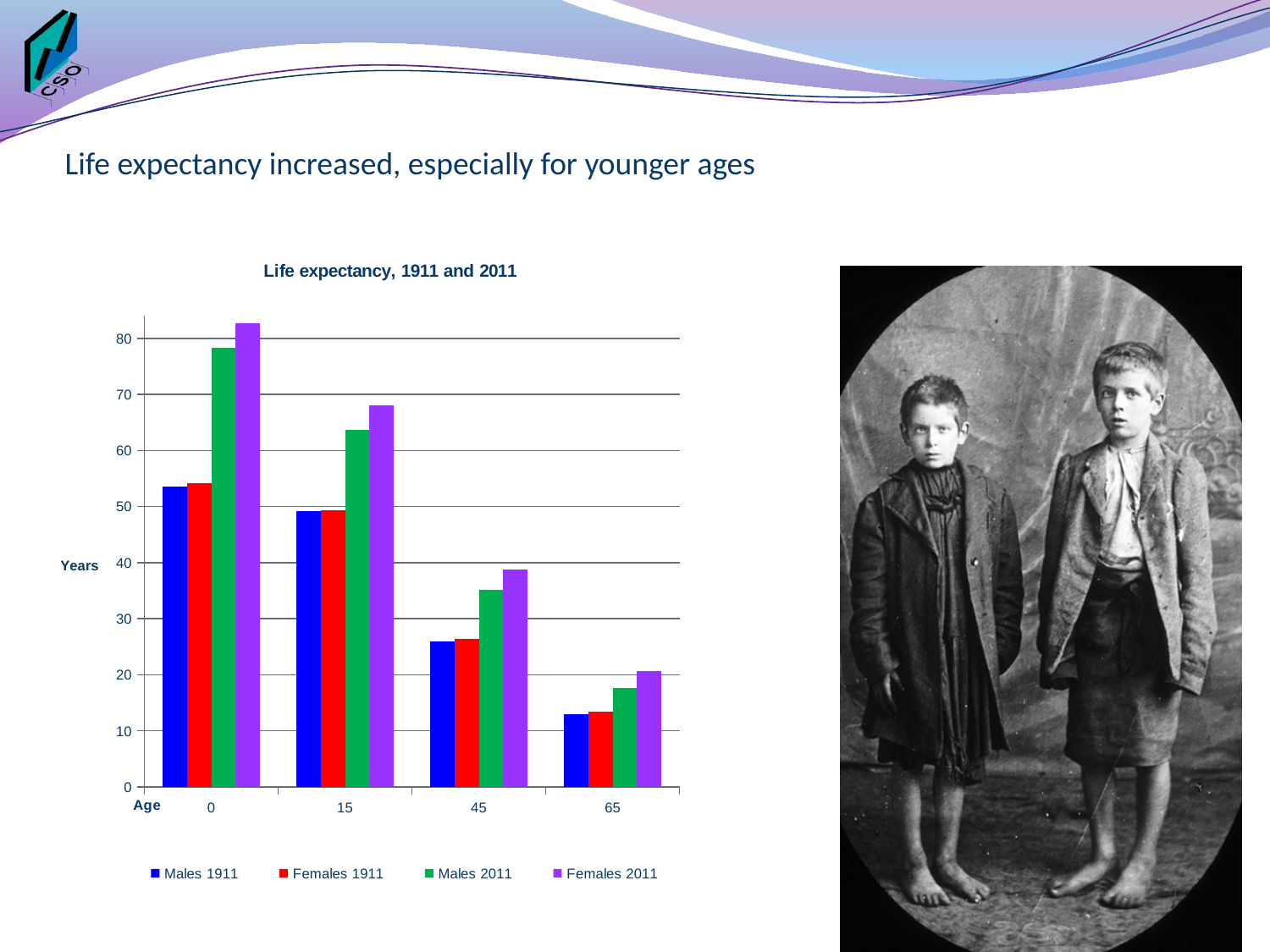
Is the Males 1911 value at age 45 greater or less than 30? less Is the Males 2011 value at age 15 greater or less than 60? greater Is the Females 1911 value at age 65 greater or less than 20? less How many age categories are shown on the x axis of the chart? 4 What kind of chart is shown on the slide? bar chart What is the title of the chart? Life expectancy, 1911 and 2011 Do the Females 2011 values rise or fall as age increases along the x axis? fall At which age is the Males 1911 life expectancy lowest? 65 How many series does the legend of the life expectancy chart list? 4 At which age is the Females 2011 life expectancy highest? 0 At age 65, which is larger: Males 2011 or Females 2011? Females 2011